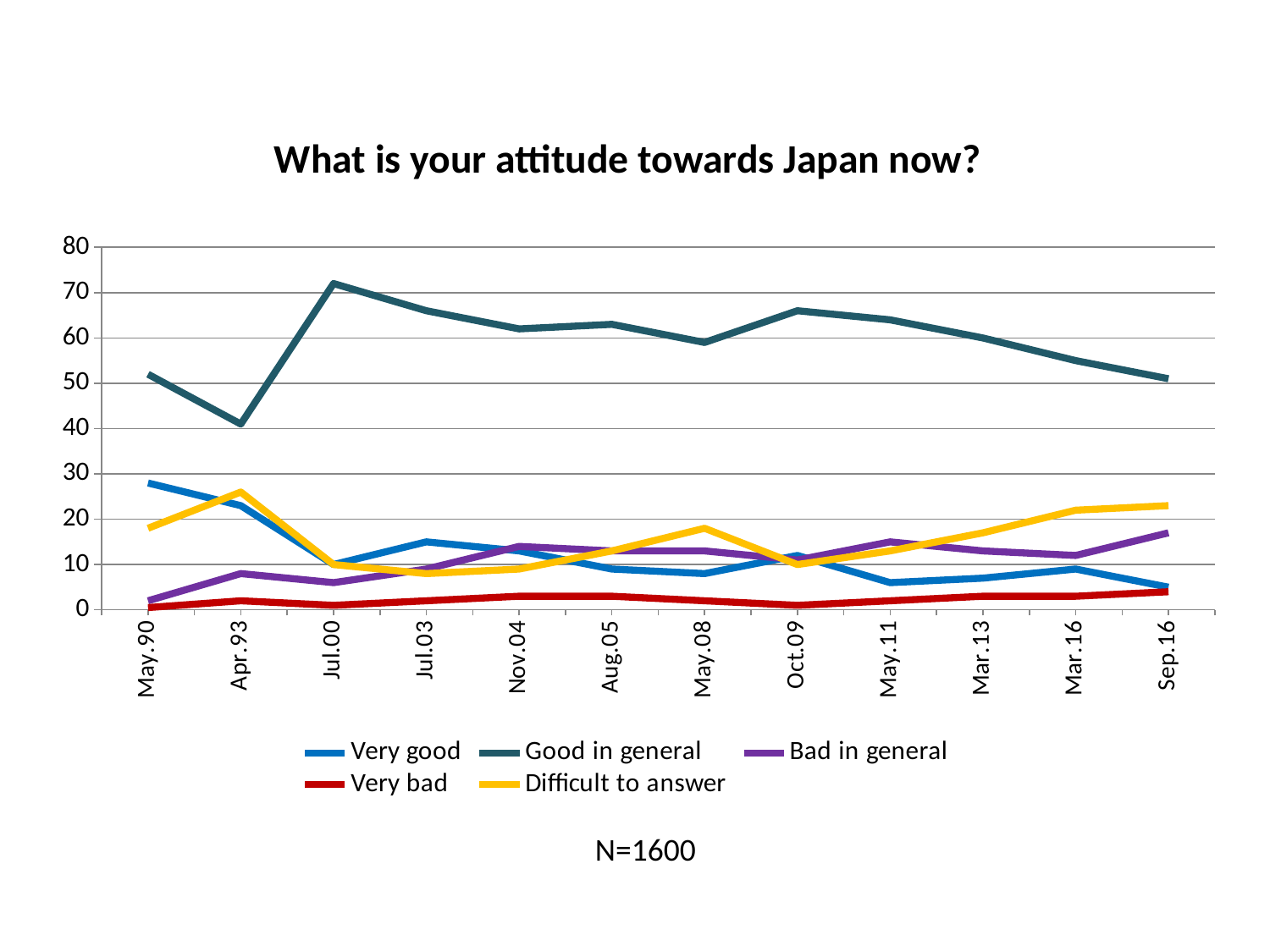
At which survey date does the 'Good in general' series reach its highest value? Jul.00 What is the title of the chart? What is your attitude towards Japan now? At which survey date is the 'Good in general' series at its lowest? Apr.93 How many series does the legend list? 5 Is the value for 'Difficult to answer' in Sep.16 greater or less than 20? greater Is the value for 'Bad in general' in May.90 greater or less than 10? less Does the 'Good in general' series rise or fall from Oct.09 to Sep.16? fall Is the value for 'Good in general' in Apr.93 greater or less than 50? less What kind of chart is shown on the slide? line chart In Sep.16, which is larger: 'Difficult to answer' or 'Very good'? Difficult to answer How many survey dates are plotted along the x axis? 12